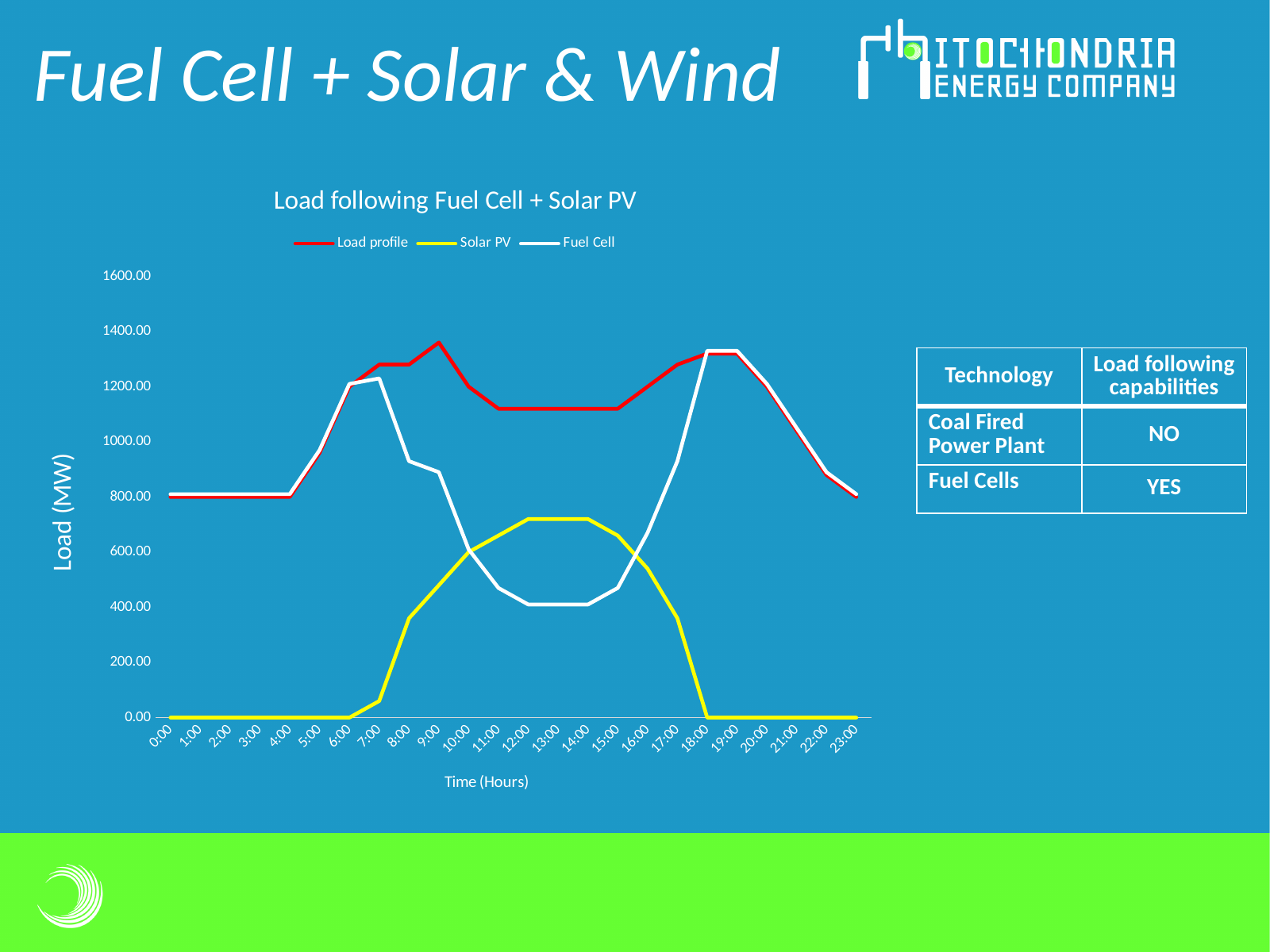
At 12:00, which is larger: the Solar PV value or the Fuel Cell value? Solar PV Does the Solar PV line rise or fall between 7:00 and 12:00? rise How many time points are shown along the x axis of the chart? 24 How many series does the chart legend list? 3 What is the Solar PV value at 3:00? 0.00 What is the Solar PV value at 21:00? 0.00 Which series has the lowest value at 20:00? Solar PV Is the Solar PV value at 12:00 greater or less than 600? greater What kind of chart is shown on the slide? line chart What is the title of the chart? Load following Fuel Cell + Solar PV Is the Load profile value at 9:00 greater or less than 1200? greater Is the Fuel Cell value at 13:00 greater or less than 600? less